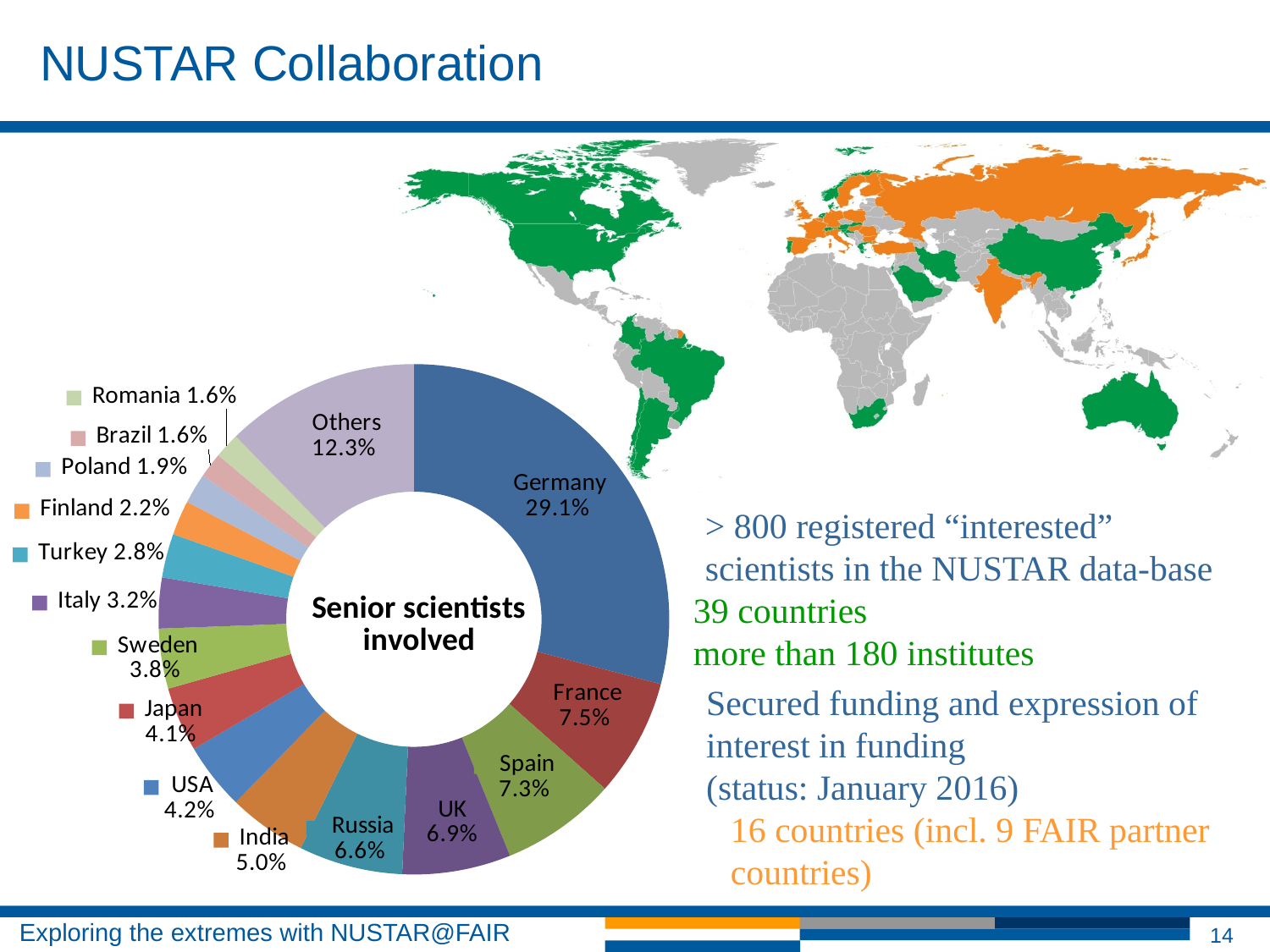
What is the value shown for India? 5.0% Which country has the largest share of senior scientists involved? Germany What kind of chart is used to show the senior scientists involved? doughnut (pie) chart How many slices does the chart have? 16 What share of the chart does France account for? 7.5% What percentage of senior scientists involved are from Germany? 29.1% Which has a larger share, Japan or USA? USA What percentage is shown for the 'Others' slice? 12.3% What is the difference between the shares of Spain and UK? 0.4% What is the difference between Germany's share and France's share? 21.6% Which has a larger share, Russia or India? Russia What is the title shown in the centre of the chart? Senior scientists involved